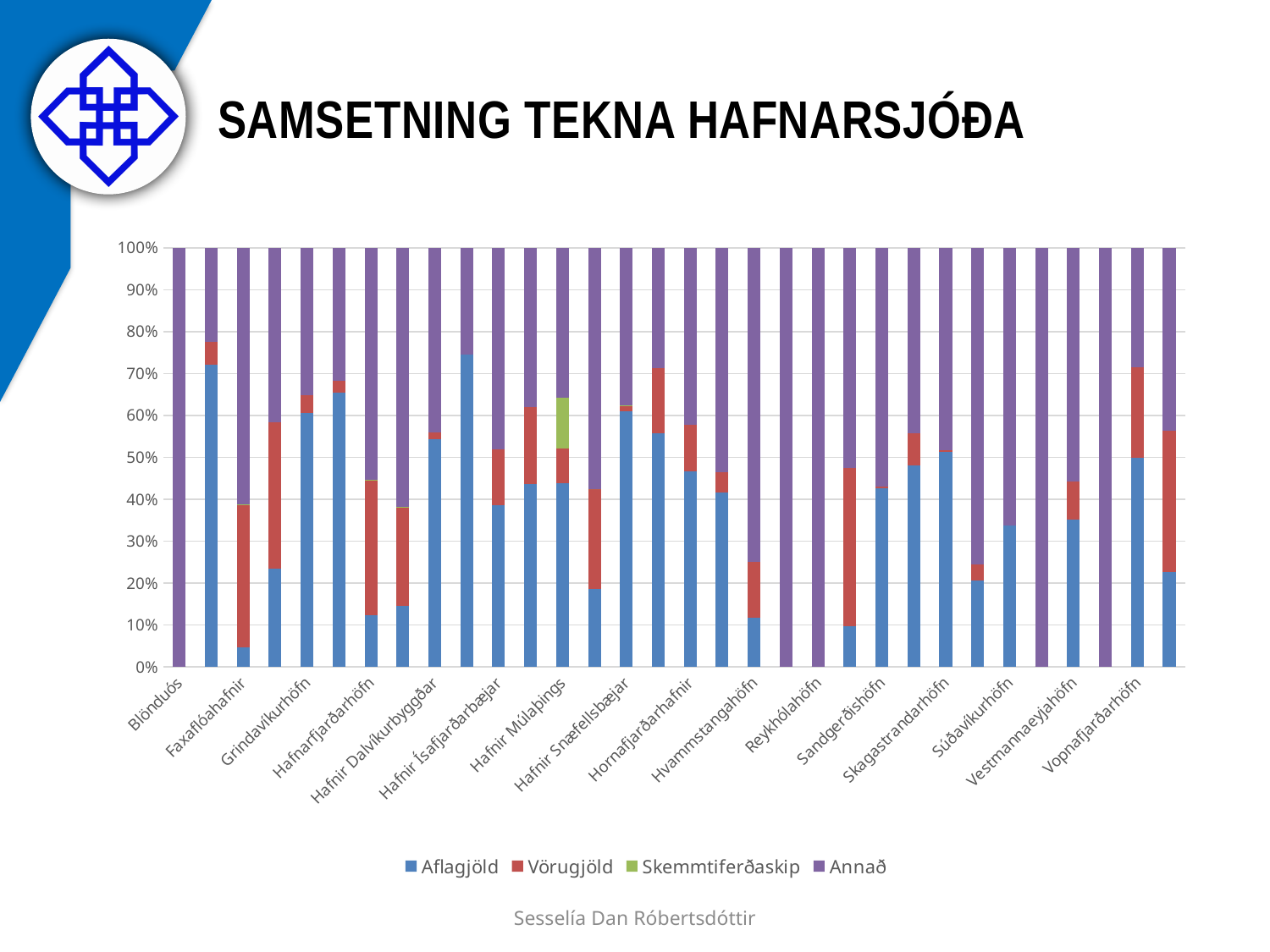
What is the maximum value shown on the vertical axis? 100% Is the Annað share for Blönduós greater or less than 90%? greater What is the title of the chart on the slide? SAMSETNING TEKNA HAFNARSJÓÐA How many series does the legend list? 4 What kind of chart is shown on the slide? Stacked bar chart Is the Aflagjöld share for Hafnir Múlaþings greater or less than 60%? less Is the Aflagjöld share for Hafnir Múlaþings greater or less than 30%? greater How many category labels are shown on the horizontal axis? 16 Which series is shown in green in the legend? Skemmtiferðaskip